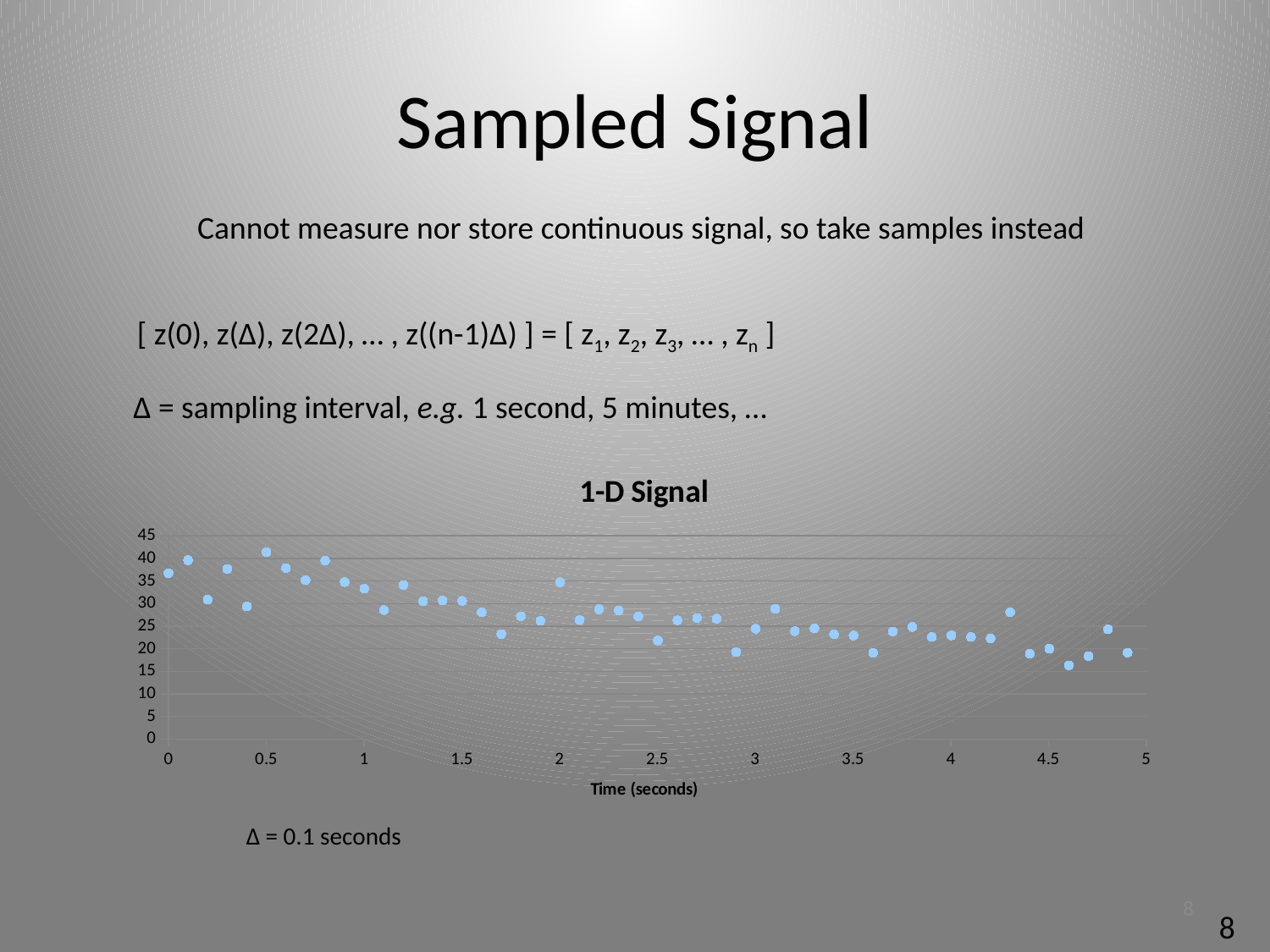
What is the label of the x axis of the chart? Time (seconds) Is the value at time 0.5 greater or less than 35? greater What kind of chart is shown on the slide? scatter chart Is the value at time 4.6 greater or less than 20? less Which is larger, the value at time 0 or the value at time 4.9? time 0 Do the plotted values generally rise or fall as time increases along the x axis? fall Is the value at time 3 greater or less than 30? less Which is larger, the value at time 0.5 or the value at time 3.5? time 0.5 What is the title of the chart? 1-D Signal